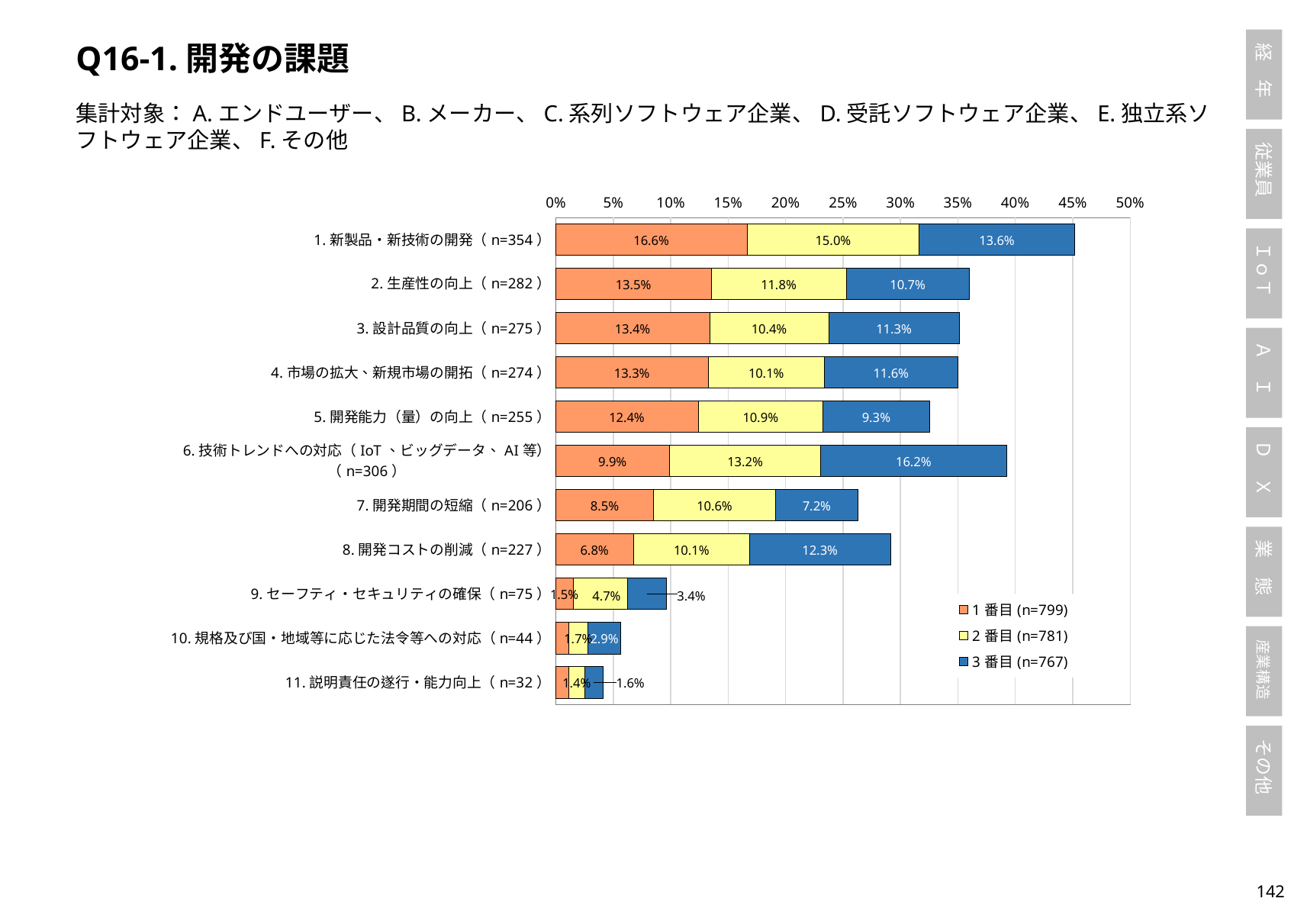
Which is larger: the 2番目 value for 1. 新製品・新技術の開発 or for 6. 技術トレンドへの対応? 1. 新製品・新技術の開発 What is the difference between the 1番目 values for 1. 新製品・新技術の開発 and 2. 生産性の向上? 3.1 percentage points What is the total of the stacked bar for 1. 新製品・新技術の開発? 45.2% Which category has the lowest 3番目 value? 11. 説明責任の遂行・能力向上 Which category has the highest 1番目 value? 1. 新製品・新技術の開発 What is the 1番目 value for 1. 新製品・新技術の開発? 16.6% How many series does the legend list? 3 What is the 3番目 value for 6. 技術トレンドへの対応（IoT、ビッグデータ、AI等）? 16.2% What is the n value shown in the legend for the 1番目 series? n=799 What is the 2番目 value for 8. 開発コストの削減? 10.1% What kind of chart is shown on the slide? Stacked bar chart How many categories (development issues) are plotted in the chart? 11